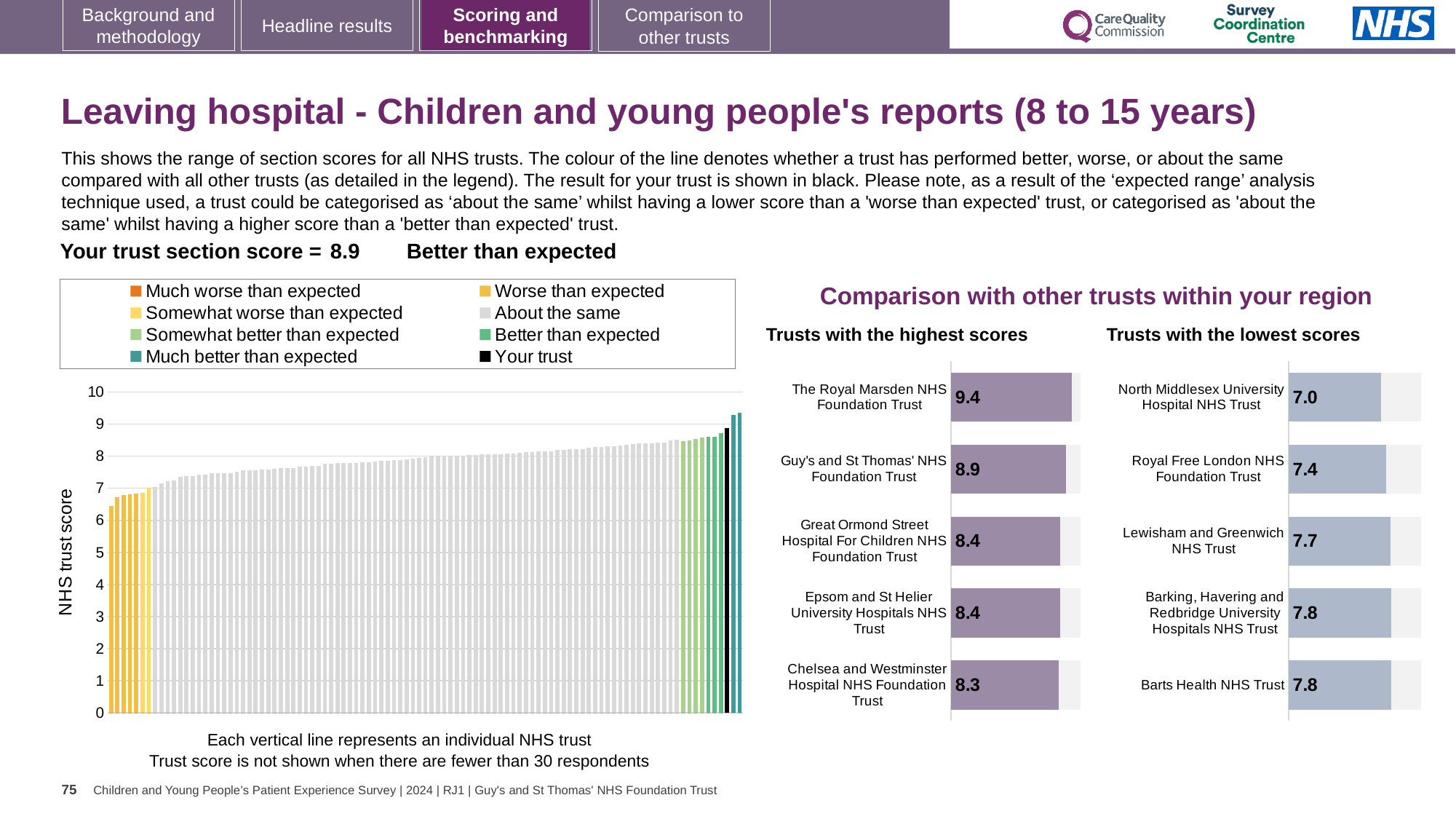
In the 'Trusts with the lowest scores' chart, what is the score for North Middlesex University Hospital NHS Trust? 7.0 How many entries does the legend of the main 'NHS trust score' chart list? 8 In the main 'NHS trust score' chart, do the bar heights rise or fall from left to right? Rise In the 'Trusts with the highest scores' chart, what is the difference between the scores of The Royal Marsden NHS Foundation Trust and Chelsea and Westminster Hospital NHS Foundation Trust? 1.1 In the 'Trusts with the lowest scores' chart, which trust has the lowest score? North Middlesex University Hospital NHS Trust In the 'Trusts with the highest scores' chart, what is the score for The Royal Marsden NHS Foundation Trust? 9.4 In the main 'NHS trust score' chart, is the value of the black 'Your trust' bar greater or less than 8? greater In the 'Trusts with the lowest scores' chart, what is the difference between the scores of Barts Health NHS Trust and North Middlesex University Hospital NHS Trust? 0.8 What kind of chart is the main 'NHS trust score' chart on the left of the slide? Bar chart How many trusts are shown in the 'Trusts with the highest scores' chart? 5 In the 'Trusts with the lowest scores' chart, which has the larger score: Royal Free London NHS Foundation Trust or Lewisham and Greenwich NHS Trust? Lewisham and Greenwich NHS Trust In the 'Trusts with the highest scores' chart, which trust has the highest score? The Royal Marsden NHS Foundation Trust